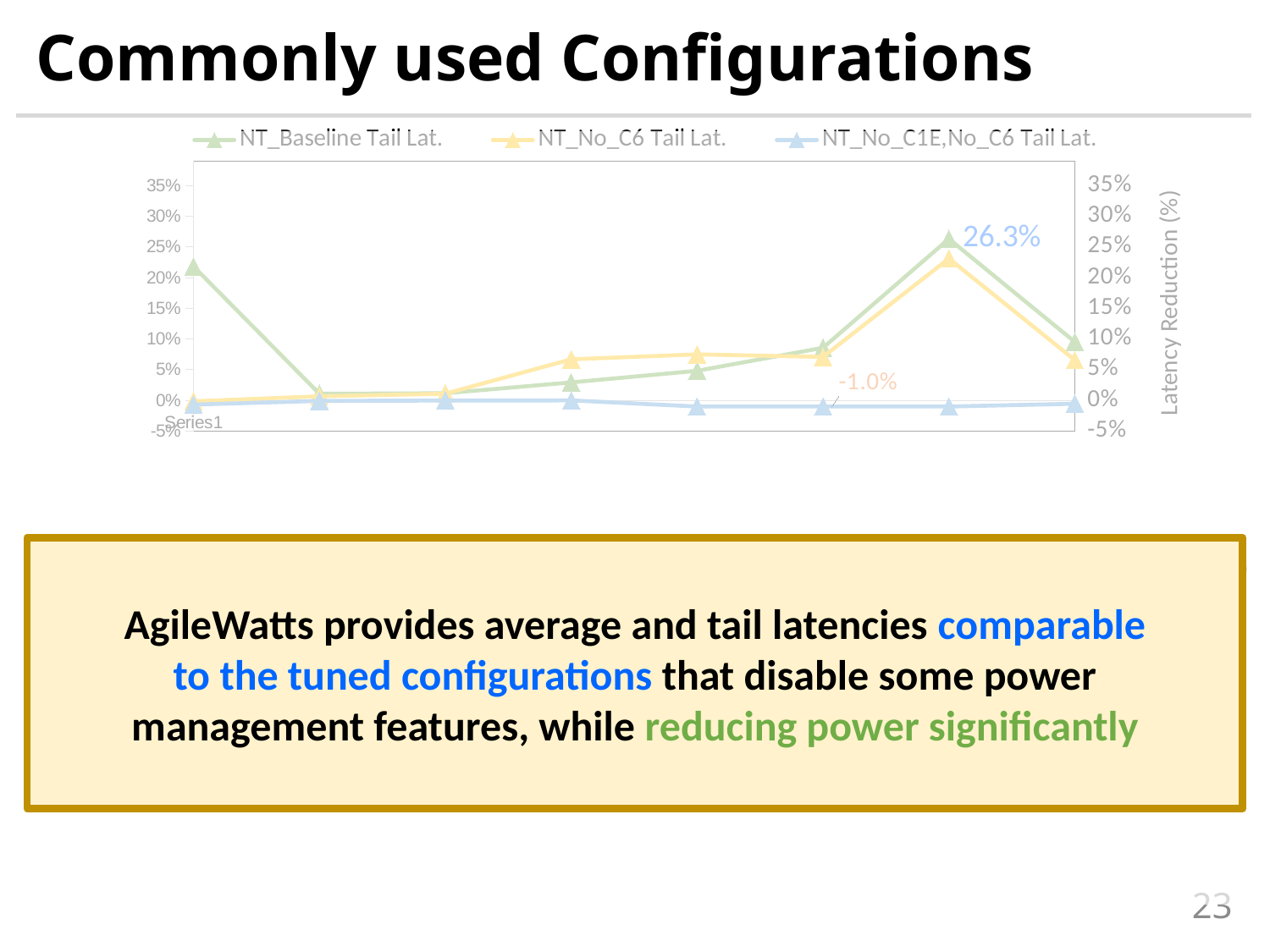
Which series stays lowest across the chart, remaining near 0%? NT_No_C1E,No_C6 Tail Lat. What is the lowest data label value printed on the chart? -1.0% How many series does the chart legend list? 3 What is the title of the right-hand vertical axis of the chart? Latency Reduction (%) What is the highest data label value printed on the chart? 26.3% What kind of chart is shown on the slide? line chart Does the NT_Baseline Tail Lat. series rise or fall from its first point to its second point? fall Is the peak value of NT_No_C6 Tail Lat. greater or less than 25%? less At the peak (seventh point), which series is higher: NT_Baseline Tail Lat. or NT_No_C6 Tail Lat.? NT_Baseline Tail Lat. How many data points does each series in the chart have? 8 Which series reaches the highest value on the chart? NT_Baseline Tail Lat. What are the three series named in the chart legend? NT_Baseline Tail Lat., NT_No_C6 Tail Lat., NT_No_C1E,No_C6 Tail Lat.